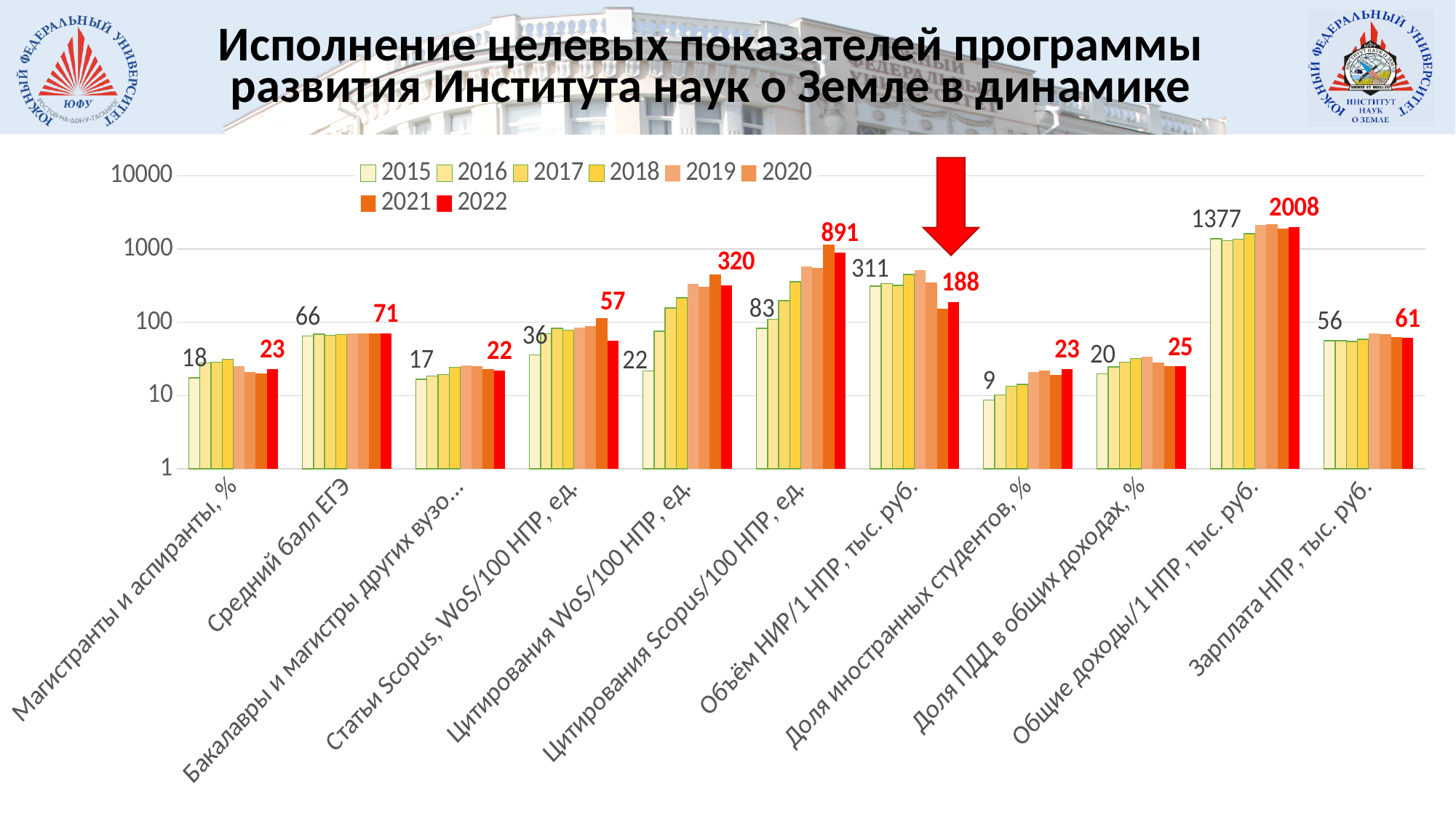
What is the difference between the 2022 and 2015 values for Общие доходы/1 НПР, тыс. руб.? 631 Is the 2022 value for Цитирования WoS/100 НПР, ед. greater or less than 100? greater Which category has the lowest 2015 value? Доля иностранных студентов, % What kind of chart is shown on the slide? Bar chart How many categories are shown on the x axis? 11 What is the 2015 value for Объём НИР/1 НПР, тыс. руб.? 311 How many series does the legend list? 8 What is the 2015 value for Доля иностранных студентов, %? 9 Which is larger for Объём НИР/1 НПР, тыс. руб.: the 2015 value or the 2022 value? 2015 What is the 2022 value for Зарплата НПР, тыс. руб.? 61 What is the 2022 value for Цитирования Scopus/100 НПР, ед.? 891 Which category has the highest 2022 value? Общие доходы/1 НПР, тыс. руб.